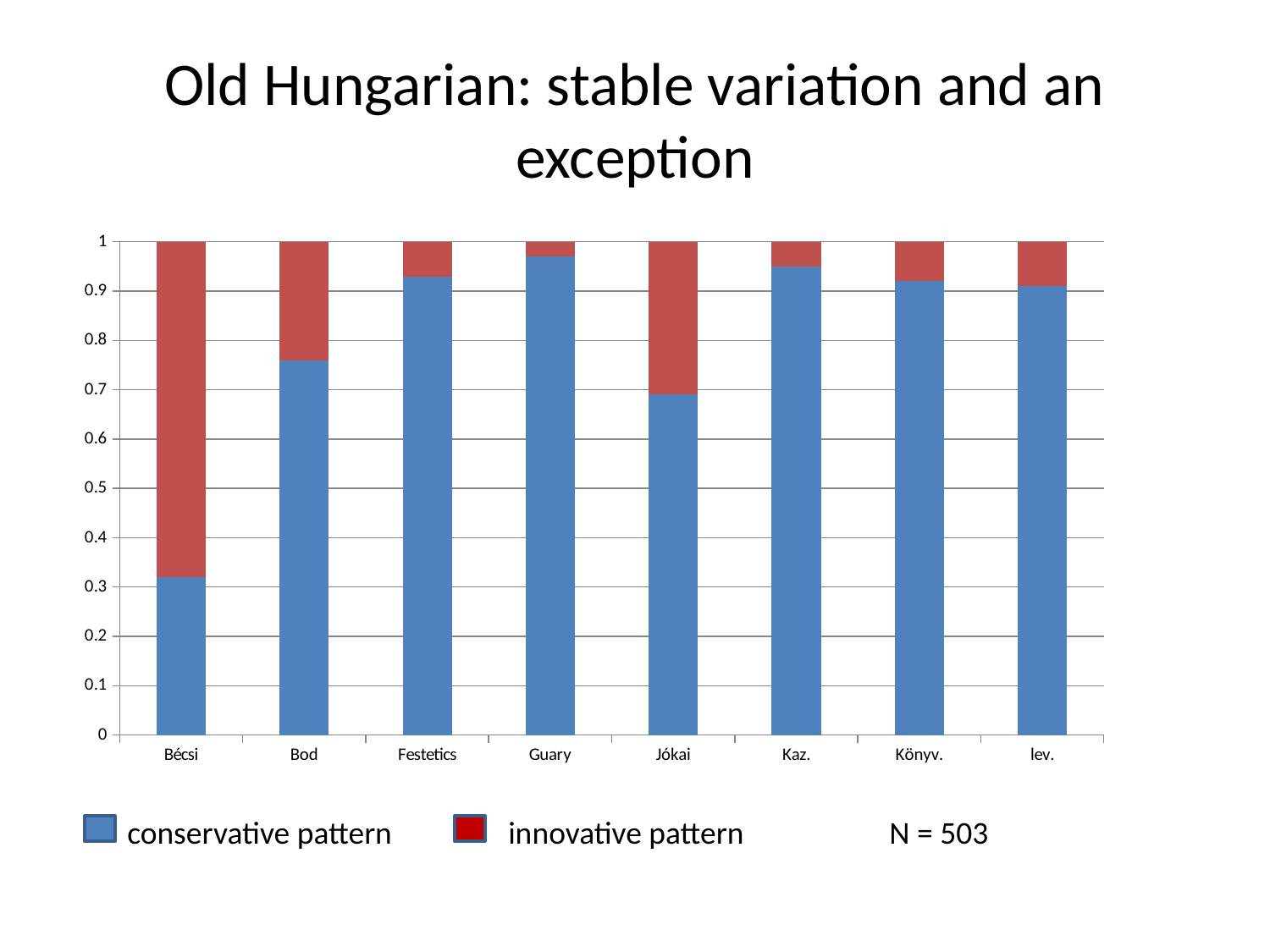
Which category has the lowest value for the conservative pattern? Bécsi Is the conservative pattern value for Festetics greater or less than 0.9? greater How many categories are shown along the x axis of the chart? 8 Is the conservative pattern value for Bécsi greater or less than 0.4? less What is the total height of the stacked bar for Bécsi? 1 Is the conservative pattern value for Jókai greater or less than 0.6? greater How many series does the chart's legend list? 2 Which has the larger conservative pattern value, Bod or Jókai? Bod Which category has the highest value for the innovative pattern? Bécsi What kind of chart is shown on the slide? bar chart Which colour represents the innovative pattern in the chart? red